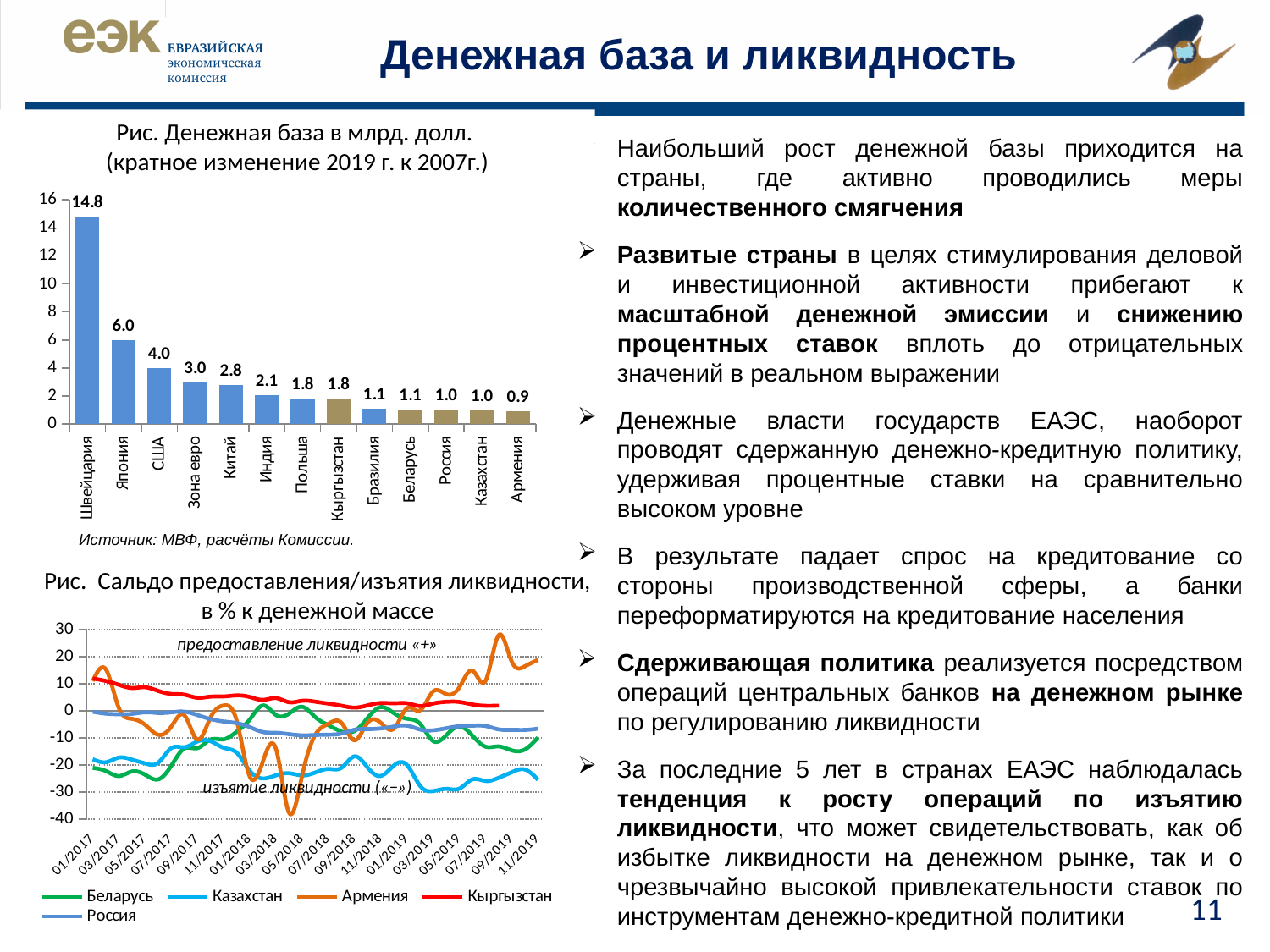
On the bar chart 'Денежная база в млрд. долл.', how many countries are shown? 13 On the line chart 'Сальдо предоставления/изъятия ликвидности', is the value for Казахстан at 01/2017 greater or less than 0? less On the bar chart 'Денежная база в млрд. долл.', what is the value for Япония? 6.0 On the line chart 'Сальдо предоставления/изъятия ликвидности', how many series does the legend list? 5 On the line chart 'Сальдо предоставления/изъятия ликвидности', which colour is used for the Армения series? orange What type of chart is the top chart 'Денежная база в млрд. долл.'? bar chart On the bar chart 'Денежная база в млрд. долл.', what is the difference between the values for Швейцария and Япония? 8.8 On the bar chart 'Денежная база в млрд. долл.', what is the value for Швейцария? 14.8 On the bar chart 'Денежная база в млрд. долл.', which country has the highest value? Швейцария On the bar chart 'Денежная база в млрд. долл.', what is the value for Кыргызстан? 1.8 On the bar chart 'Денежная база в млрд. долл.', which country has the lowest value? Армения On the bar chart 'Денежная база в млрд. долл.', which is larger, the value for США or the value for Китай? США